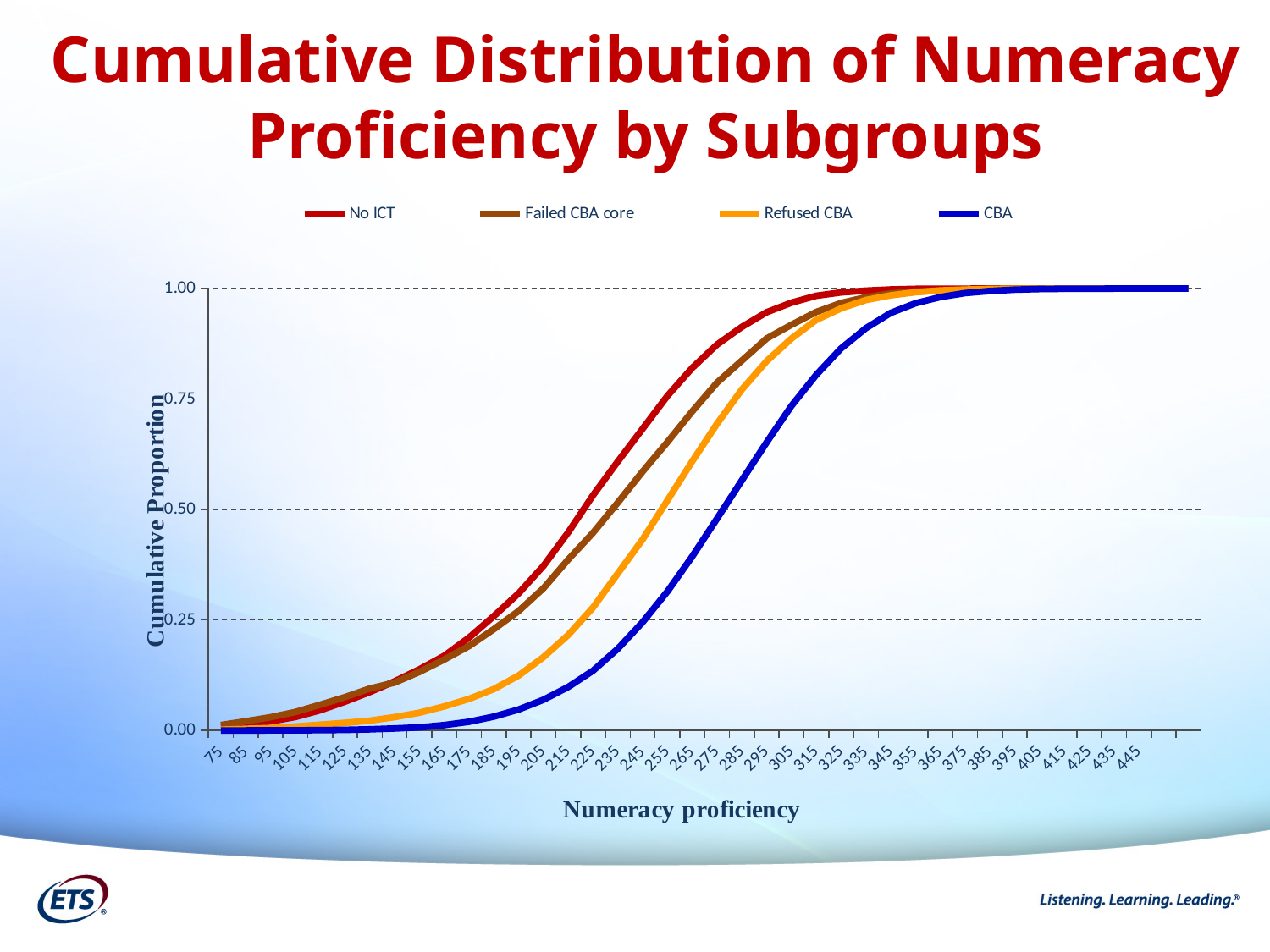
Which series is drawn in blue? CBA At numeracy proficiency 225, which series has the larger cumulative proportion, Failed CBA core or Refused CBA? Failed CBA core Do the values of the No ICT series rise or fall as numeracy proficiency increases? rise At numeracy proficiency 255, which series has the larger cumulative proportion, No ICT or CBA? No ICT What kind of chart is shown on the slide? line chart Is the value for No ICT at numeracy proficiency 305 greater or less than 0.75? greater Is the value for No ICT at numeracy proficiency 205 greater or less than 0.25? greater How many series does the legend list? 4 Is the value for Failed CBA core at numeracy proficiency 175 greater or less than 0.25? less What is the label of the x axis? Numeracy proficiency